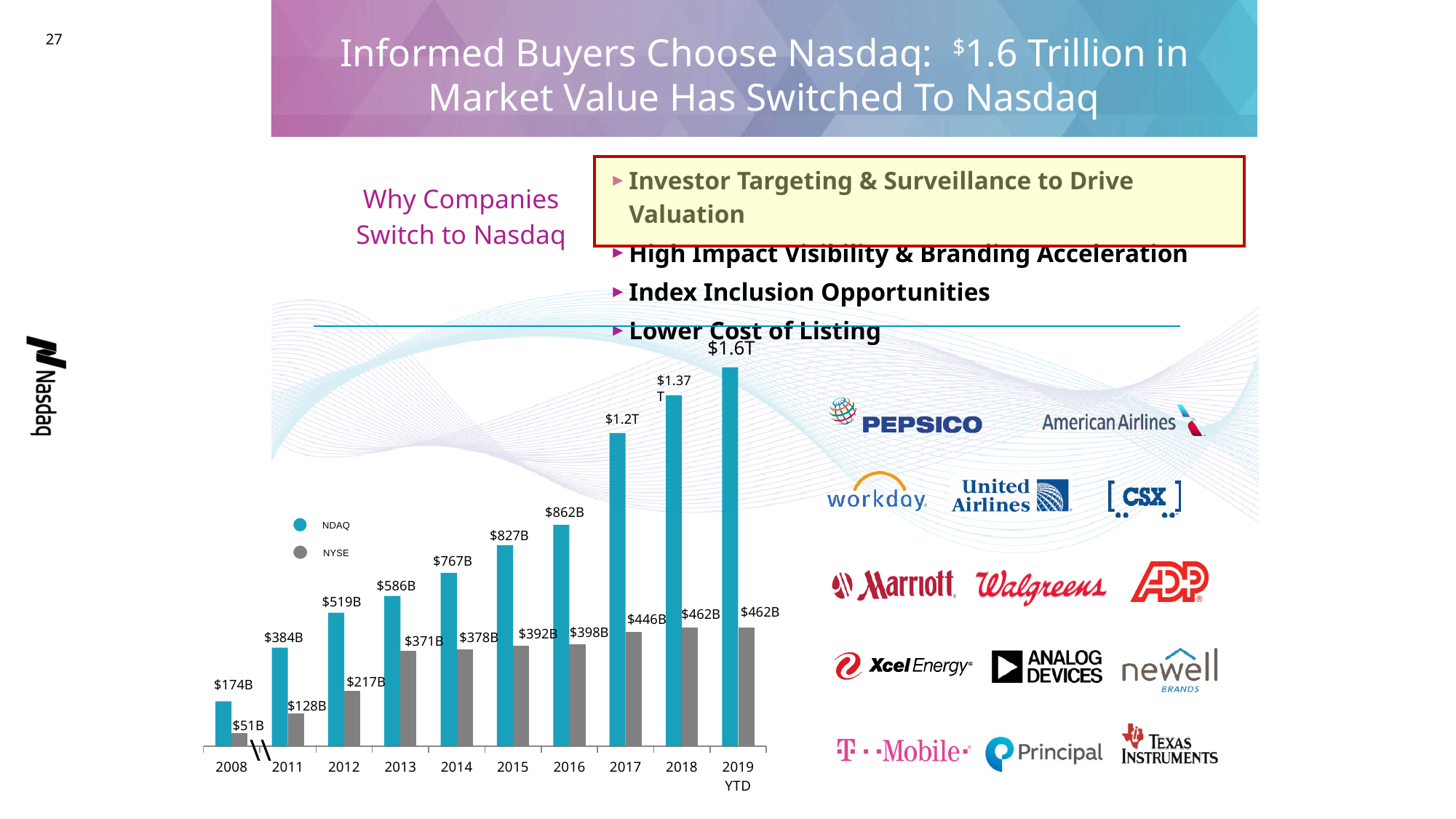
Which is larger in 2014, the NDAQ value or the NYSE value? NDAQ Which year has the lowest NYSE value? 2008 Which year has the highest NDAQ value? 2019 YTD What kind of chart is shown on the slide? Bar chart What is the NYSE value for 2012? $217B How many years are shown on the x axis of the chart? 10 What is the NYSE value for 2017? $446B What is the difference between the NDAQ and NYSE values in 2016? $464B What is the difference between the NDAQ and NYSE values in 2012? $302B How many series does the chart's legend list? 2 What is the NDAQ value for 2016? $862B What is the NDAQ value for 2019 YTD? $1.6T